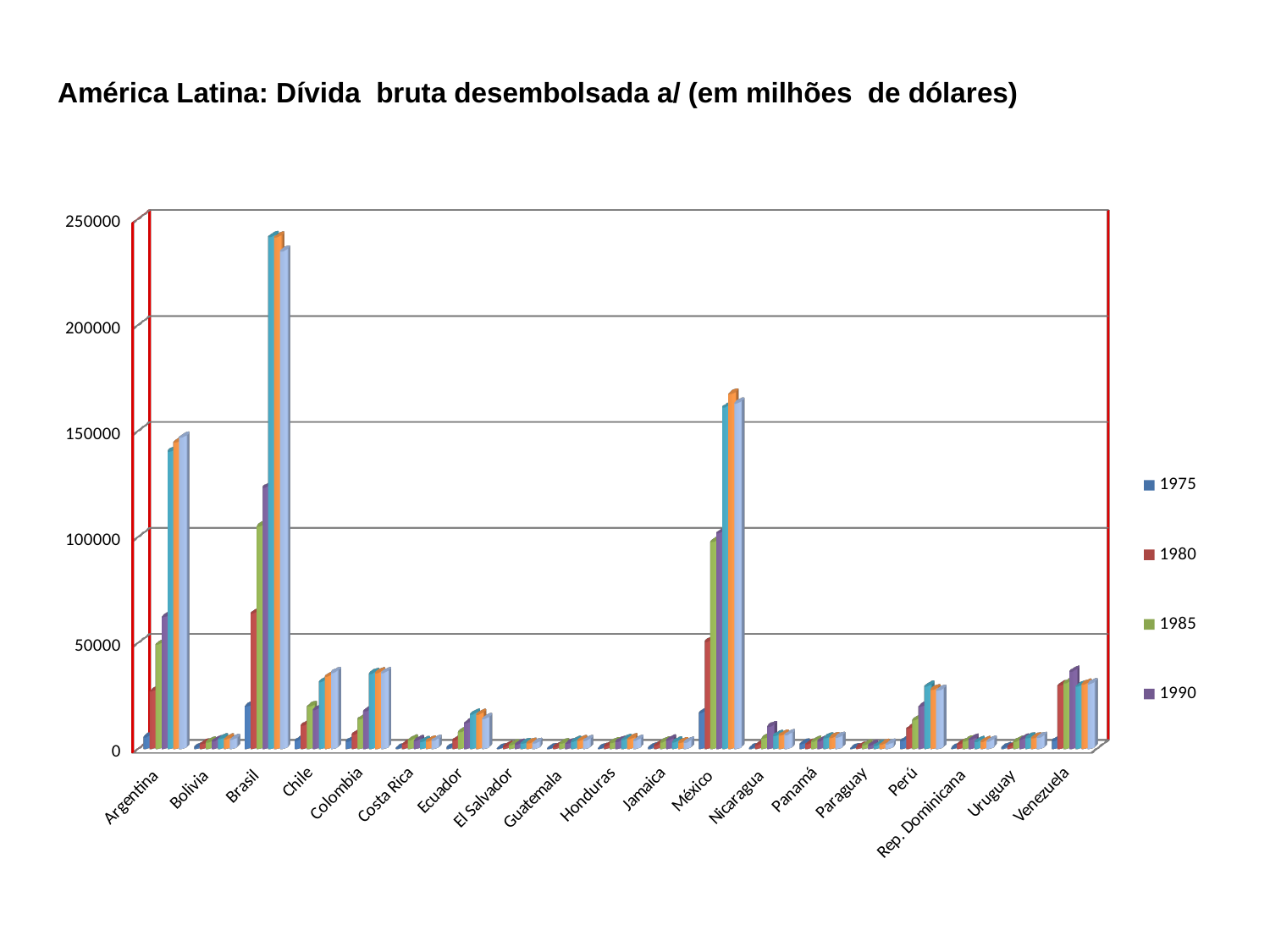
What is the title of the chart? América Latina: Dívida bruta desembolsada a/ (em milhões de dólares) Which country has the higher peak value, Brasil or México? Brasil Is the tallest bar for Chile greater or less than 50000? less What kind of chart is shown on the slide? bar chart Which country has the higher peak value, México or Argentina? México Is the tallest bar for Argentina greater or less than 100000? greater Within the Argentina group, do the bars rise or fall from left to right? rise Is the tallest bar for Brasil greater or less than 200000? greater How many countries are shown on the x axis of the chart? 19 Which country has the tallest bar in the chart? Brasil